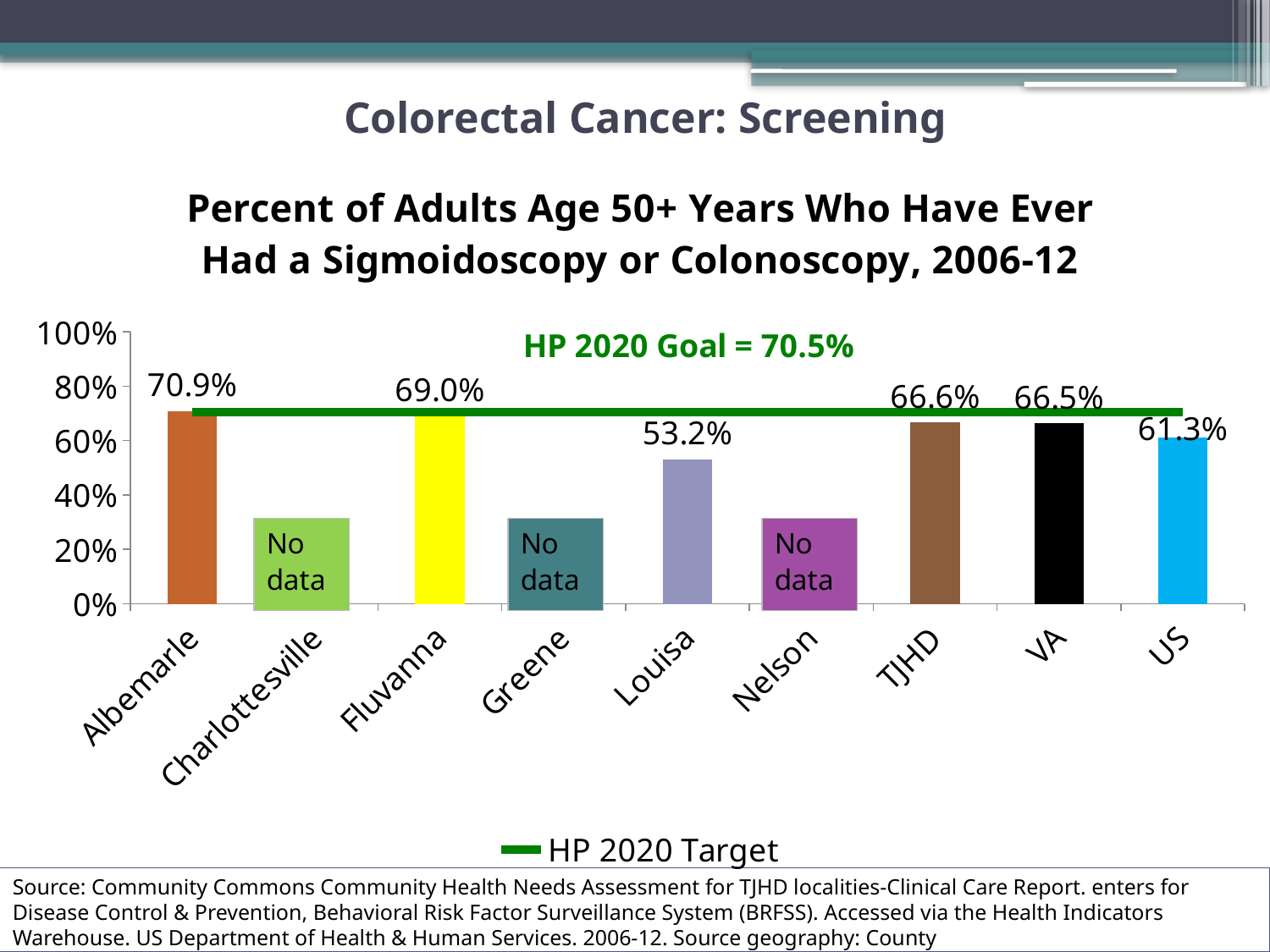
What is the value for Albemarle? 70.9% What is the difference between the values for Albemarle and Fluvanna? 1.9 percentage points What is the value for TJHD? 66.6% What kind of chart is shown on the slide? bar chart Which locality has the highest screening percentage? Albemarle What is the value for Louisa? 53.2% Among the categories with data, which has the lowest value? Louisa What is the HP 2020 Goal shown on the chart? 70.5% Is the value for Louisa greater or less than 60%? less Which is larger, the value for Fluvanna or the value for US? Fluvanna What is the value for US? 61.3% How many categories are shown on the x axis? 9